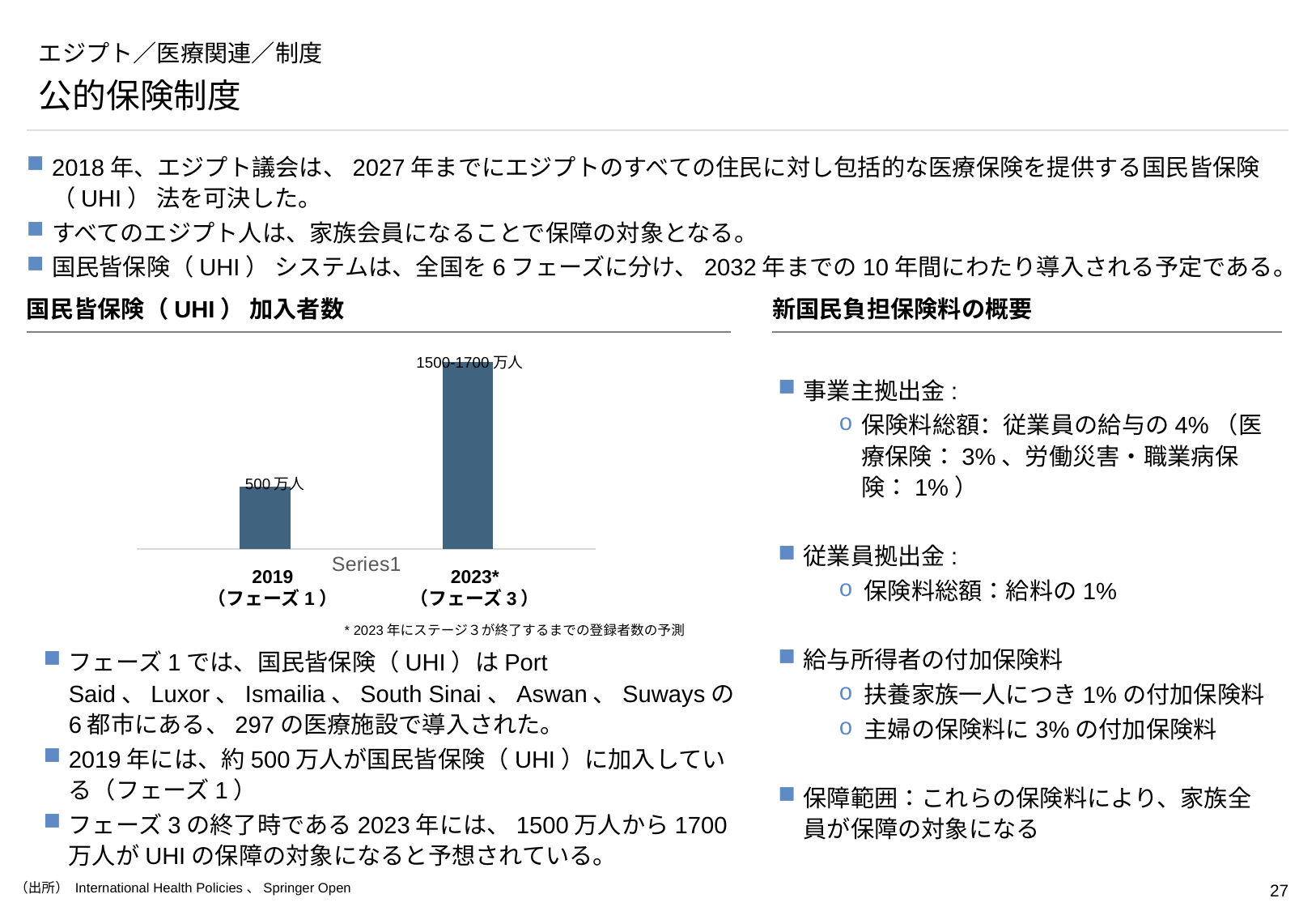
In the 国民皆保険（UHI）加入者数 chart, which is larger: the value for 2019 or the value for 2023*? 2023* What kind of chart is used to show 国民皆保険（UHI）加入者数? Bar chart Which category has the highest bar in the 国民皆保険（UHI）加入者数 chart? 2023*（フェーズ3） Do the values in the 国民皆保険（UHI）加入者数 chart rise or fall from 2019 to 2023*? Rise Which category has the lowest bar in the 国民皆保険（UHI）加入者数 chart? 2019（フェーズ1） What does the asterisk footnote below the chart say about the 2023* value? 2023年にステージ3が終了するまでの登録者数の予測 What is the value shown for 2019 (フェーズ1) in the 国民皆保険（UHI）加入者数 chart? 500万人 What is the title of the chart on the slide? 国民皆保険（UHI）加入者数 What is the value shown for 2023* (フェーズ3) in the 国民皆保険（UHI）加入者数 chart? 1500-1700万人 How many bars are plotted in the 国民皆保険（UHI）加入者数 chart? 2